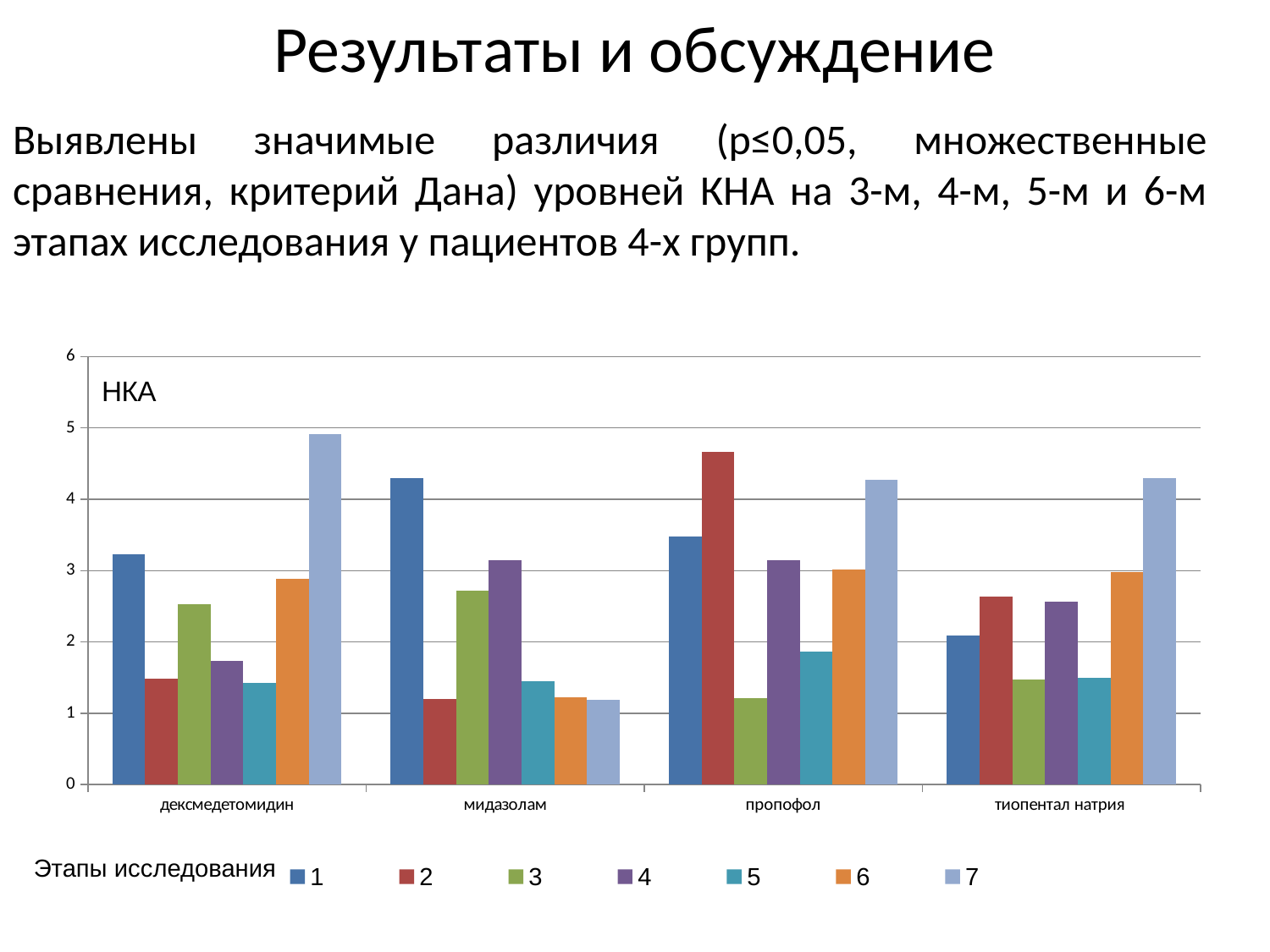
For мидазолам, which stage (series) has the highest bar? 1 How many drug categories are shown on the x axis of the chart? 4 For пропофол, which stage (series) has the lowest bar? 3 How many series does the chart legend list? 7 For тиопентал натрия, which stage (series) has the highest bar? 7 What label is written inside the plot area near the top of the y axis? НКА What kind of chart is shown on the slide? bar chart For дексмедетомидин, which stage (series) has the highest bar? 7 Is the value for stage 7 for дексмедетомидин greater or less than 4? greater Is the value for stage 3 for пропофол greater or less than 2? less Which is larger: the stage 1 value for дексмедетомидин or the stage 1 value for мидазолам? мидазолам